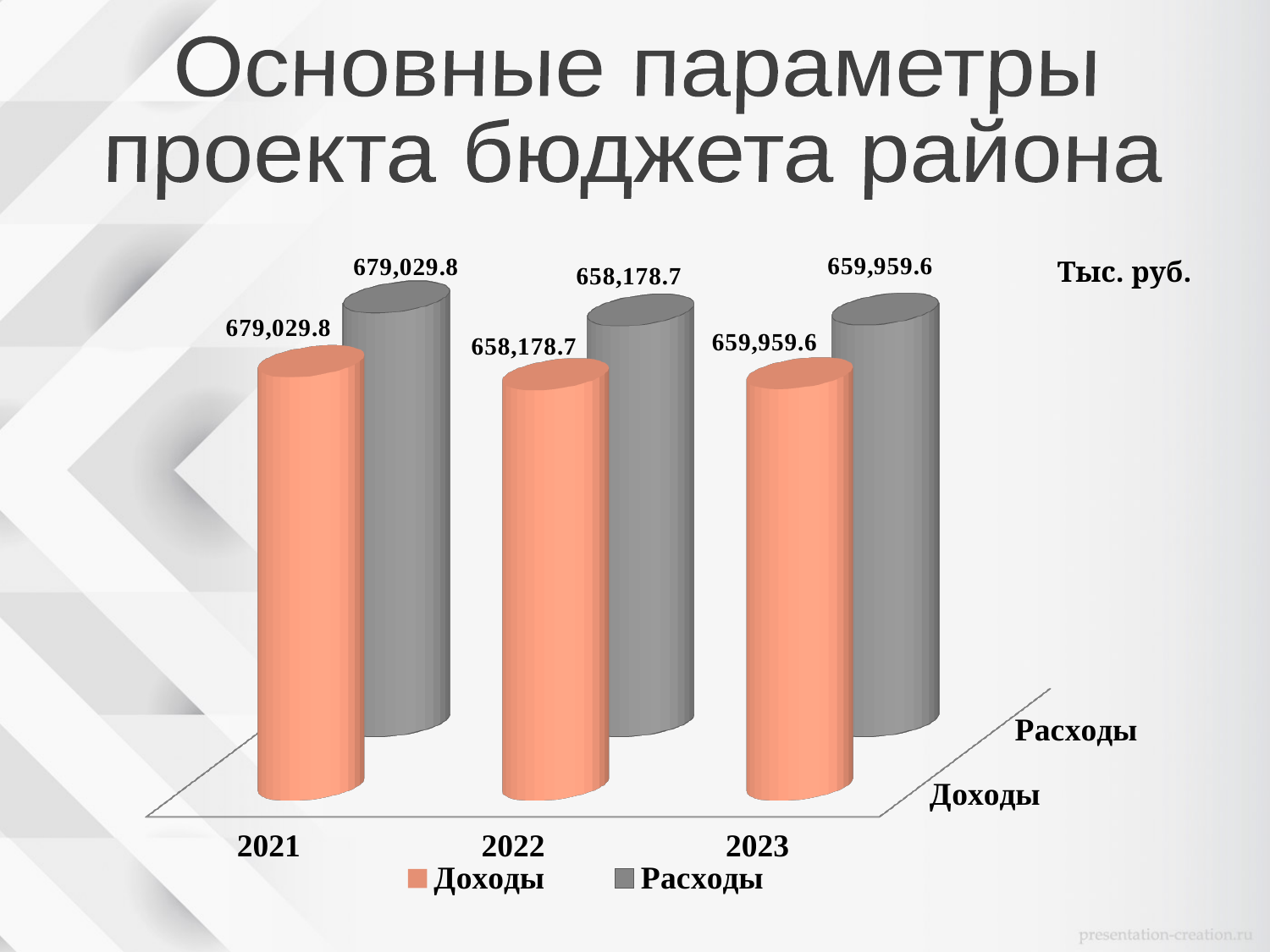
Which is larger: Доходы in 2021 or Доходы in 2023? Доходы in 2021 What is the value for Доходы in 2021? 679,029.8 What is the value for Расходы in 2022? 658,178.7 In which year is the value for Расходы highest? 2021 How many series does the legend list? 2 What is the difference between the Доходы values for 2021 and 2022? 20,851.1 What is the difference between the Расходы values for 2023 and 2022? 1,780.9 Is the value for Доходы in 2021 larger than, smaller than, or equal to the value for Расходы in 2021? equal What kind of chart is shown on the slide? bar chart How many years are shown on the x axis? 3 What is the value for Доходы in 2023? 659,959.6 In which year is the value for Доходы lowest? 2022